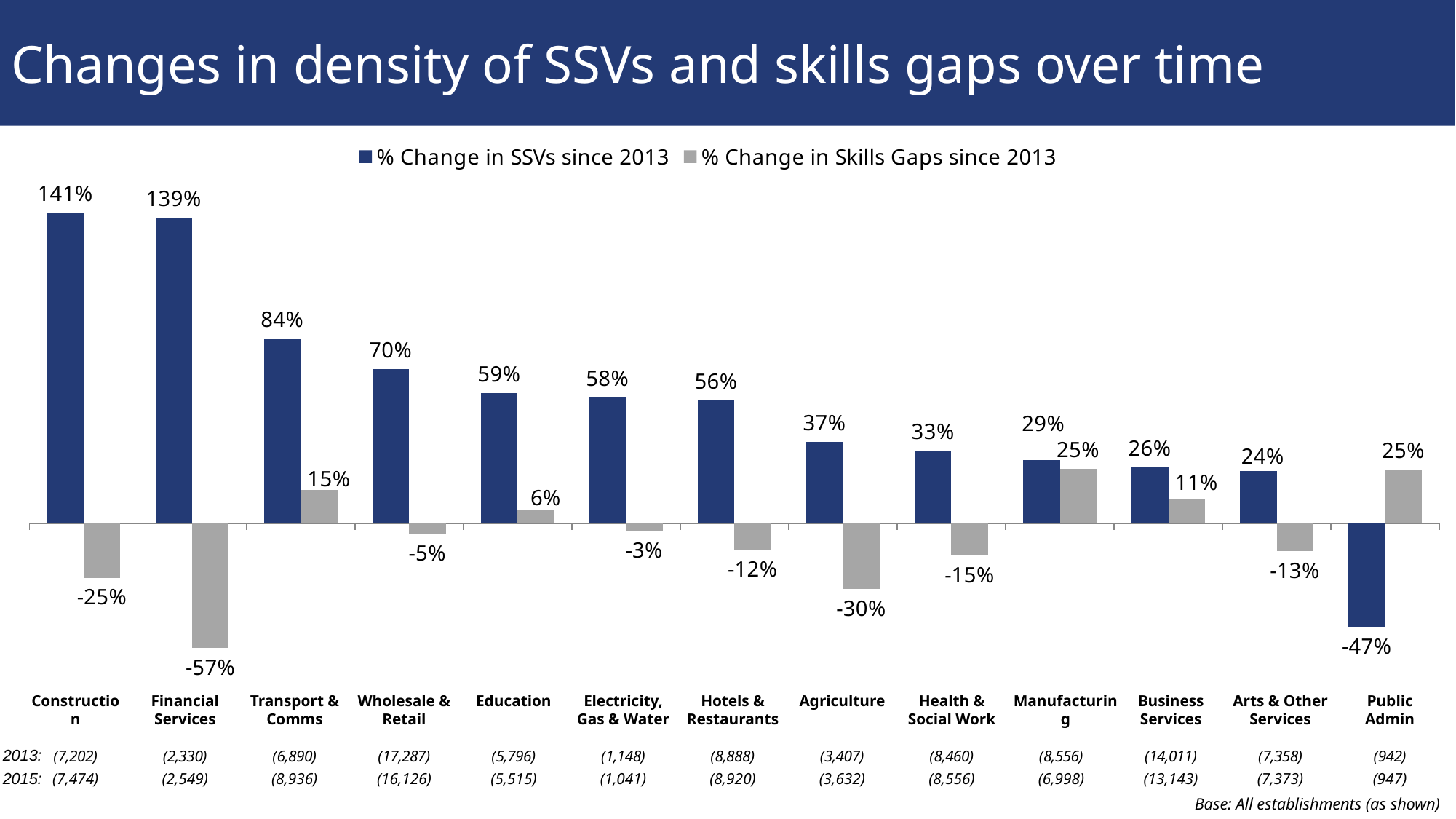
How many series does the legend list? 2 Which colour represents the % Change in Skills Gaps since 2013 series? Grey What is the % Change in Skills Gaps since 2013 for Financial Services? -57% How many sectors are shown on the x axis? 13 What is the % Change in Skills Gaps since 2013 for Agriculture? -30% Which sector has the highest % Change in SSVs since 2013? Construction Which sector has the lowest % Change in Skills Gaps since 2013? Financial Services What is the % Change in SSVs since 2013 for Construction? 141% Which is larger: the % Change in Skills Gaps since 2013 for Transport & Comms or for Business Services? Transport & Comms What is the % Change in SSVs since 2013 for Public Admin? -47% What is the difference between the % Change in SSVs since 2013 for Transport & Comms and for Wholesale & Retail? 14 percentage points What kind of chart is shown on the slide? Bar chart